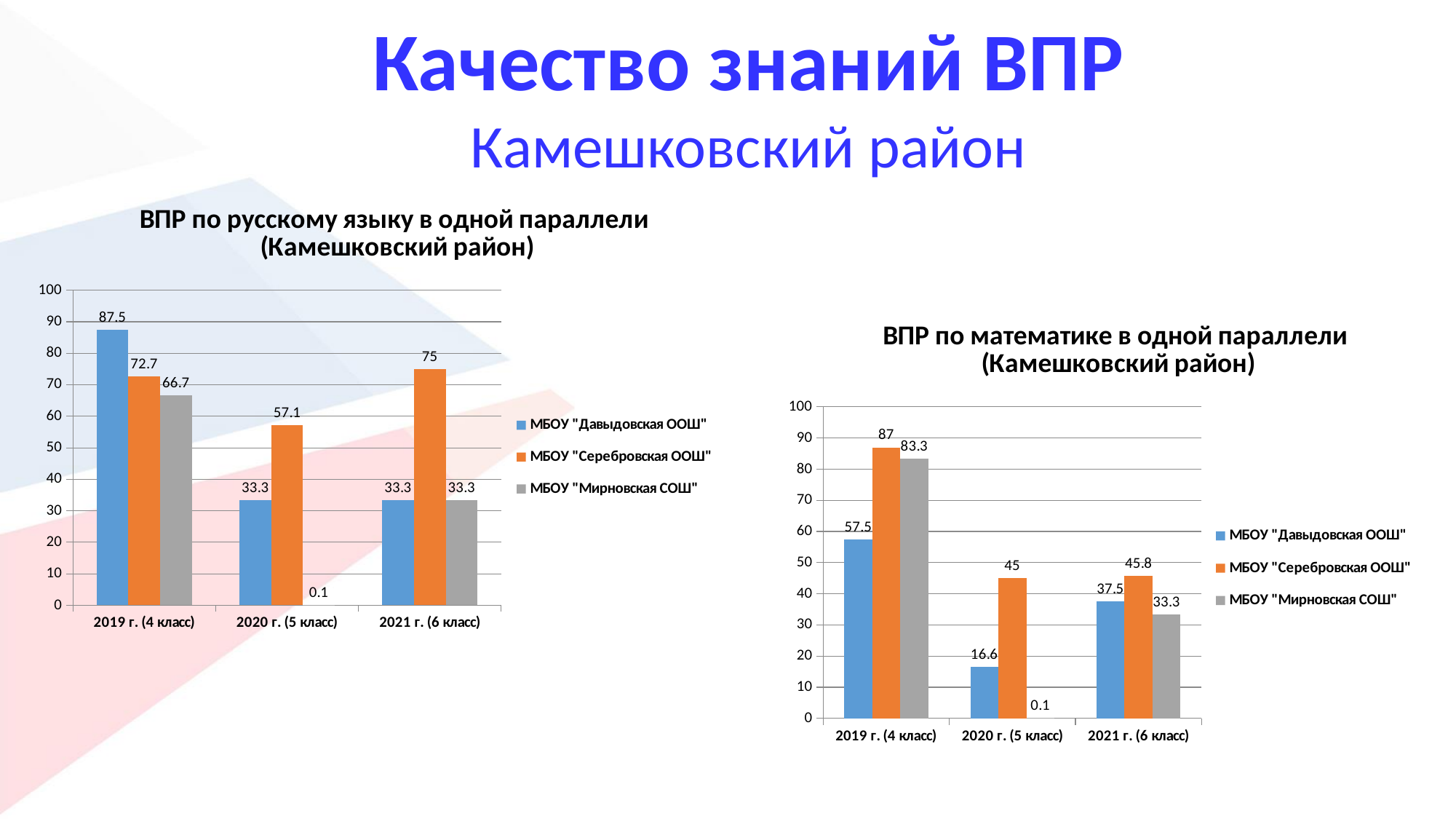
In the chart "ВПР по русскому языку в одной параллели (Камешковский район)", what is the value for МБОУ "Серебровская ООШ" in 2021 г. (6 класс)? 75 How many series does the legend of the chart "ВПР по математике в одной параллели (Камешковский район)" list? 3 In the chart "ВПР по русскому языку в одной параллели (Камешковский район)", which school has the highest value in 2020 г. (5 класс)? МБОУ "Серебровская ООШ" In the chart "ВПР по математике в одной параллели (Камешковский район)", what is the value for МБОУ "Серебровская ООШ" in 2019 г. (4 класс)? 87 In the chart "ВПР по математике в одной параллели (Камешковский район)", what is the value for МБОУ "Давыдовская ООШ" in 2020 г. (5 класс)? 16.6 In the chart "ВПР по математике в одной параллели (Камешковский район)", which school has the lowest value in 2021 г. (6 класс)? МБОУ "Мирновская СОШ" In the chart "ВПР по математике в одной параллели (Камешковский район)", what is the difference between МБОУ "Серебровская ООШ" and МБОУ "Давыдовская ООШ" in 2021 г. (6 класс)? 8.3 In the chart "ВПР по русскому языку в одной параллели (Камешковский район)", what is the value for МБОУ "Мирновская СОШ" in 2020 г. (5 класс)? 0.1 In the chart "ВПР по русскому языку в одной параллели (Камешковский район)", what is the difference between МБОУ "Давыдовская ООШ" and МБОУ "Мирновская СОШ" in 2019 г. (4 класс)? 20.8 In the chart "ВПР по математике в одной параллели (Камешковский район)", which is larger in 2019 г. (4 класс): МБОУ "Давыдовская ООШ" or МБОУ "Мирновская СОШ"? МБОУ "Мирновская СОШ" In the chart "ВПР по русскому языку в одной параллели (Камешковский район)", what is the value for МБОУ "Давыдовская ООШ" in 2019 г. (4 класс)? 87.5 What kind of chart is "ВПР по русскому языку в одной параллели (Камешковский район)"? Bar chart